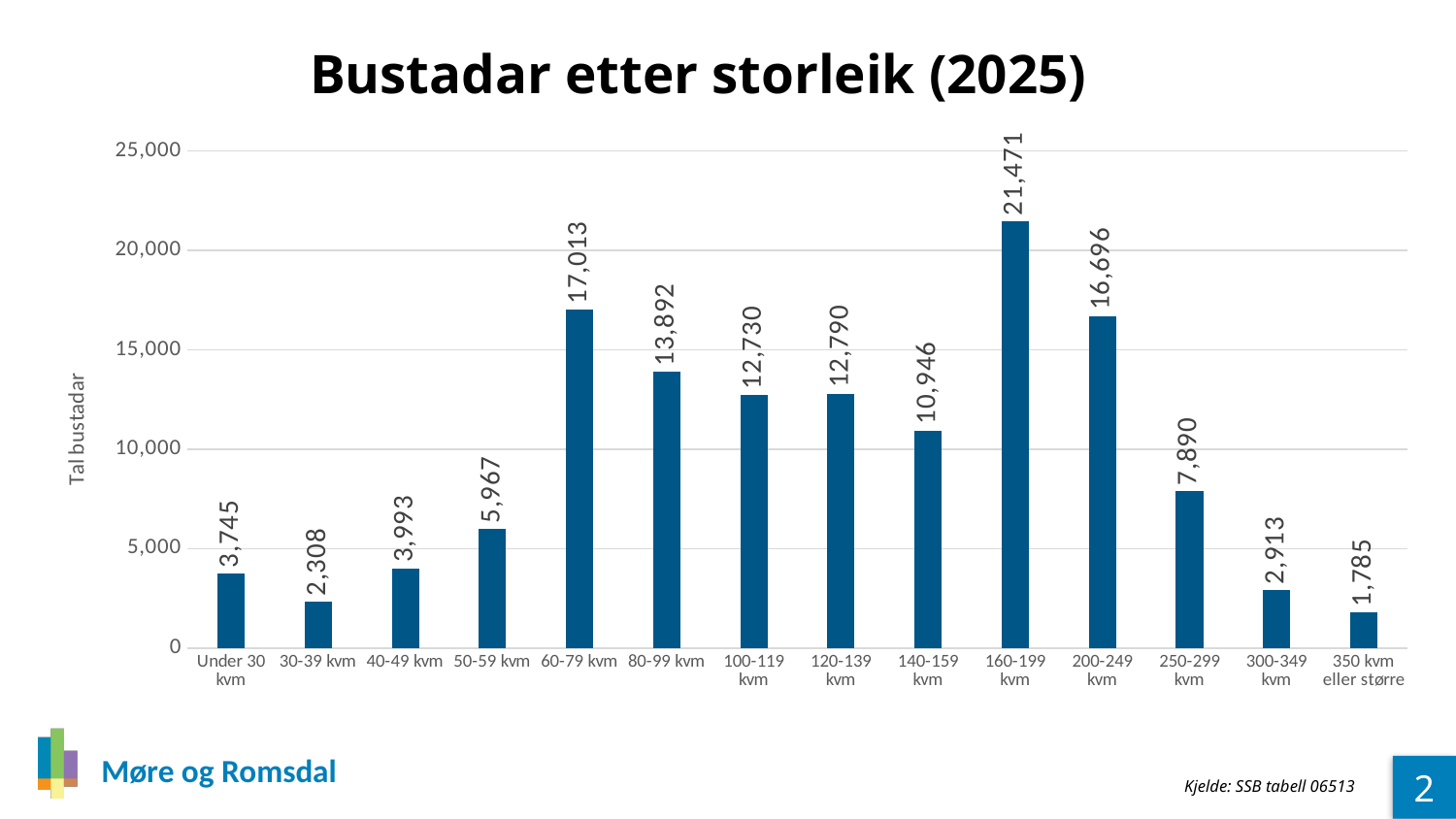
What is the value for the 50-59 kvm category? 5,967 What is the label on the vertical axis? Tal bustadar Which is larger, the value for 250-299 kvm or the value for 50-59 kvm? 250-299 kvm What kind of chart is shown on the slide? Bar chart What is the difference between the values for 200-249 kvm and 80-99 kvm? 2,804 Which category has the lowest value? 350 kvm eller større What is the value for the 160-199 kvm category? 21,471 Is the value for 140-159 kvm greater or less than 10,000? greater What is the difference between the values for 160-199 kvm and 60-79 kvm? 4,458 How many categories are shown on the x axis? 14 What is the value for the 350 kvm eller større category? 1,785 Which category has the highest value? 160-199 kvm